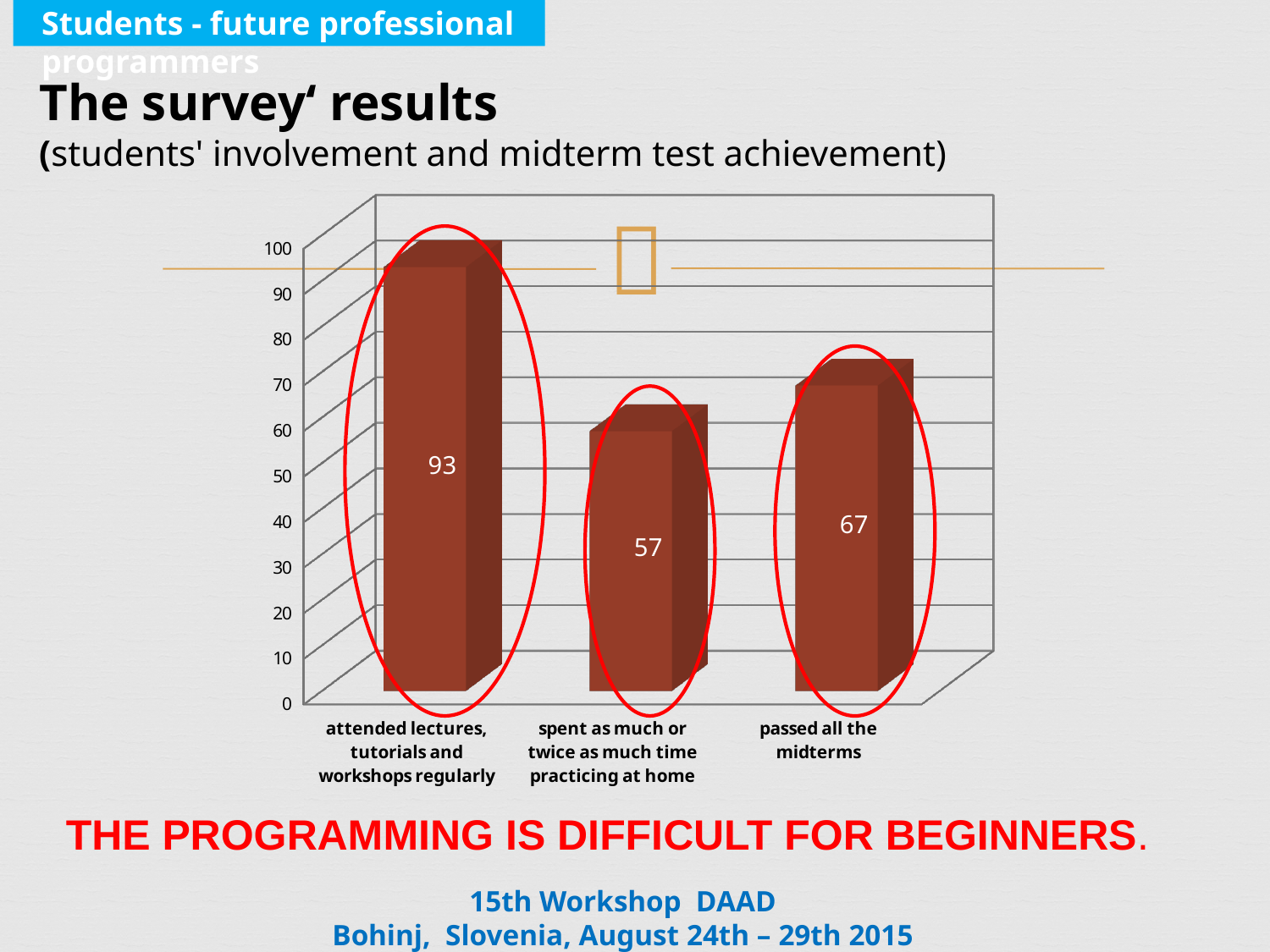
What kind of chart is shown on the slide? bar chart How many categories are shown on the chart? 3 Which category has the highest value? attended lectures, tutorials and workshops regularly What is the maximum value shown on the vertical axis? 100 Which category has the lowest value? spent as much or twice as much time practicing at home What is the difference between the values for 'attended lectures, tutorials and workshops regularly' and 'passed all the midterms'? 26 Is the value for 'spent as much or twice as much time practicing at home' greater or less than 60? less What is the value for 'spent as much or twice as much time practicing at home'? 57 Which is larger: the value for 'passed all the midterms' or the value for 'spent as much or twice as much time practicing at home'? passed all the midterms What is the difference between the values for 'passed all the midterms' and 'spent as much or twice as much time practicing at home'? 10 What is the value for 'passed all the midterms'? 67 What is the value for 'attended lectures, tutorials and workshops regularly'? 93